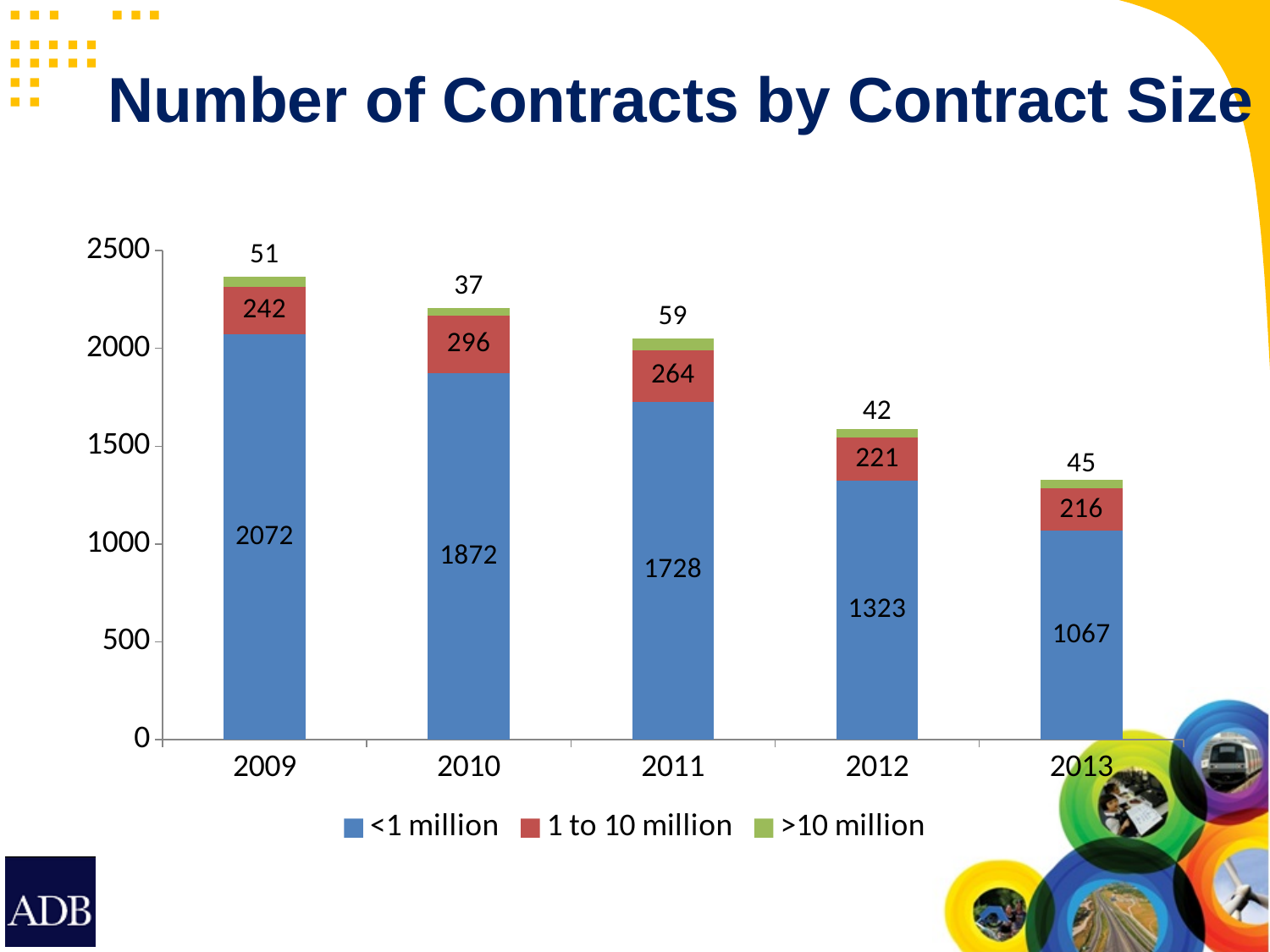
What is the number of contracts of 1 to 10 million in 2010? 296 Does the number of contracts under 1 million rise or fall from 2009 to 2013? Fall How many years are shown on the x axis? 5 Which year has the highest number of contracts under 1 million? 2009 How many series does the legend list? 3 What is the number of contracts over 10 million in 2012? 42 Which year has the lowest number of contracts over 10 million? 2010 What is the total number of contracts in 2013 across all three contract sizes? 1328 What is the number of contracts under 1 million in 2011? 1728 What type of chart is shown on the slide? Stacked bar chart Which is larger: the number of 1 to 10 million contracts in 2011 or in 2012? 2011 What is the difference between the number of contracts under 1 million in 2009 and in 2013? 1005